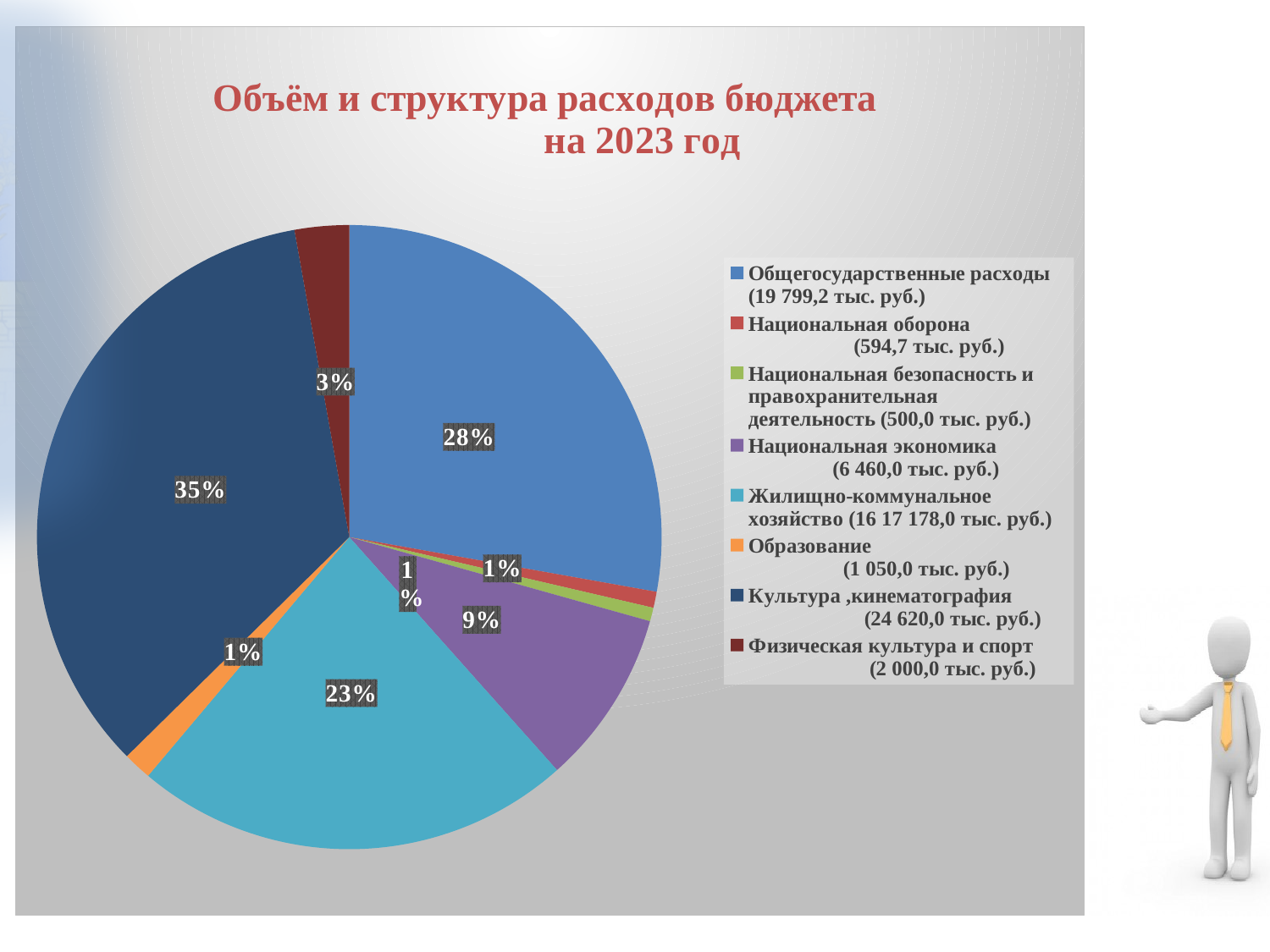
What percentage is shown for Физическая культура и спорт? 3% Which category has the largest slice of the pie? Культура, кинематография What percentage is shown for Жилищно-коммунальное хозяйство? 23% What percentage is shown for Общегосударственные расходы? 28% How many slices does the pie chart have? 8 What is the title of the chart? Объём и структура расходов бюджета на 2023 год Which is larger: the share for Общегосударственные расходы or for Жилищно-коммунальное хозяйство? Общегосударственные расходы What kind of chart is shown on the slide? pie chart What share of the pie does Культура, кинематография take? 35% What is the difference in percentage points between the Культура, кинематография slice and the Общегосударственные расходы slice? 7 What percentage is shown for Образование? 1% What percentage is shown for Национальная экономика? 9%